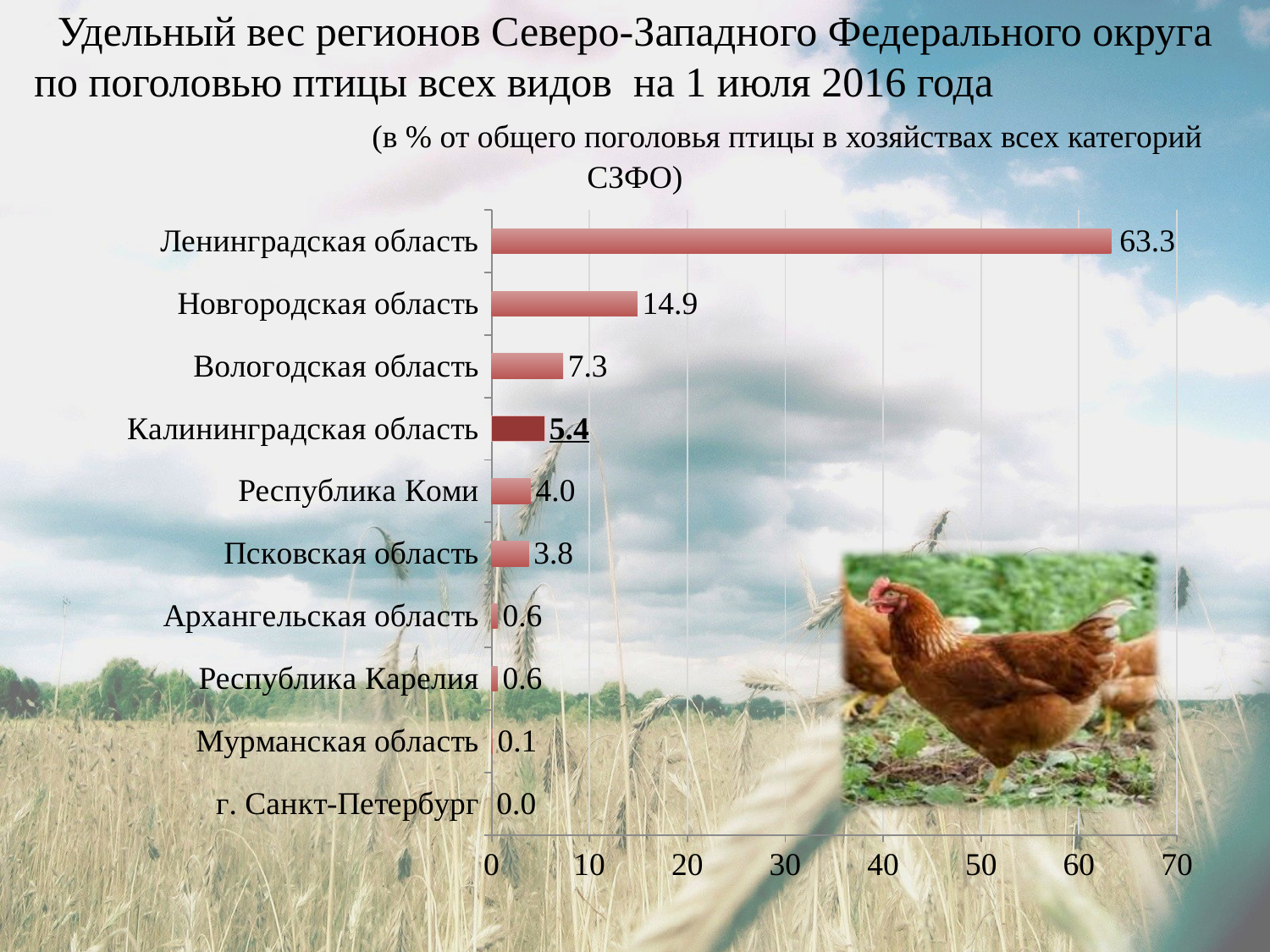
How many regions are shown in the chart? 10 What is the value for Псковская область? 3.8 What is the value for Мурманская область? 0.1 Is the value for Новгородская область greater or less than 10? greater Which region has the lowest value? г. Санкт-Петербург What kind of chart is shown on the slide? bar chart Which is larger, the value for Вологодская область or Республика Коми? Вологодская область What is the difference between the values for Ленинградская область and Новгородская область? 48.4 Which bar is highlighted in a darker colour with its label underlined? Калининградская область What is the value for Ленинградская область? 63.3 Which region has the highest value? Ленинградская область What is the value for Калининградская область? 5.4